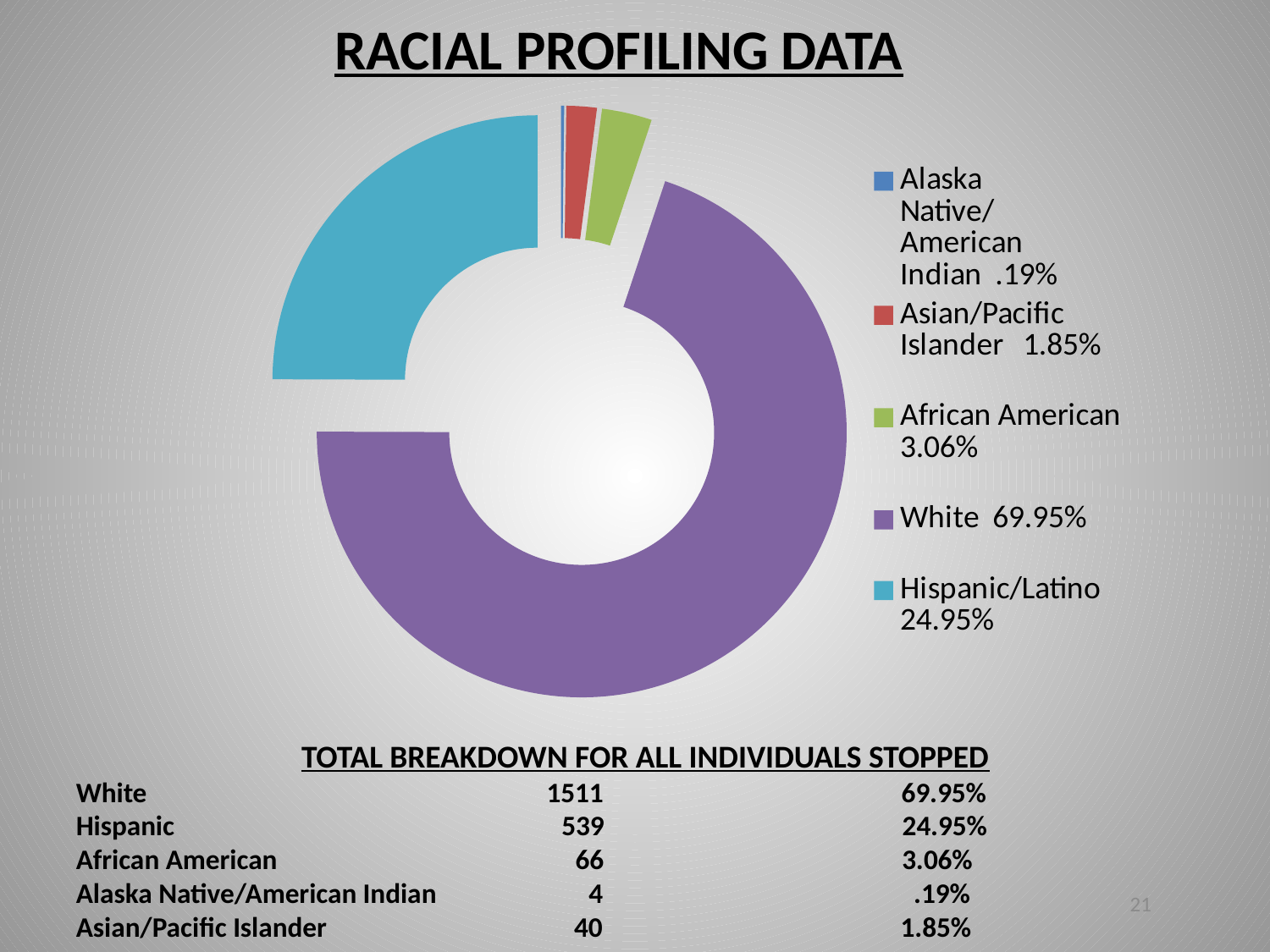
What kind of chart is shown on the slide? doughnut chart What share of the chart does Hispanic/Latino represent? 24.95% What share of the chart does White represent? 69.95% What share of the chart does African American represent? 3.06% What is the chart's title? RACIAL PROFILING DATA Which slice is larger, African American or Asian/Pacific Islander? African American How many categories does the legend of the chart list? 5 Which category has the smallest slice in the chart? Alaska Native/American Indian Which category has the largest slice in the chart? White What is the difference in percentage points between the White and Hispanic/Latino slices? 45 percentage points